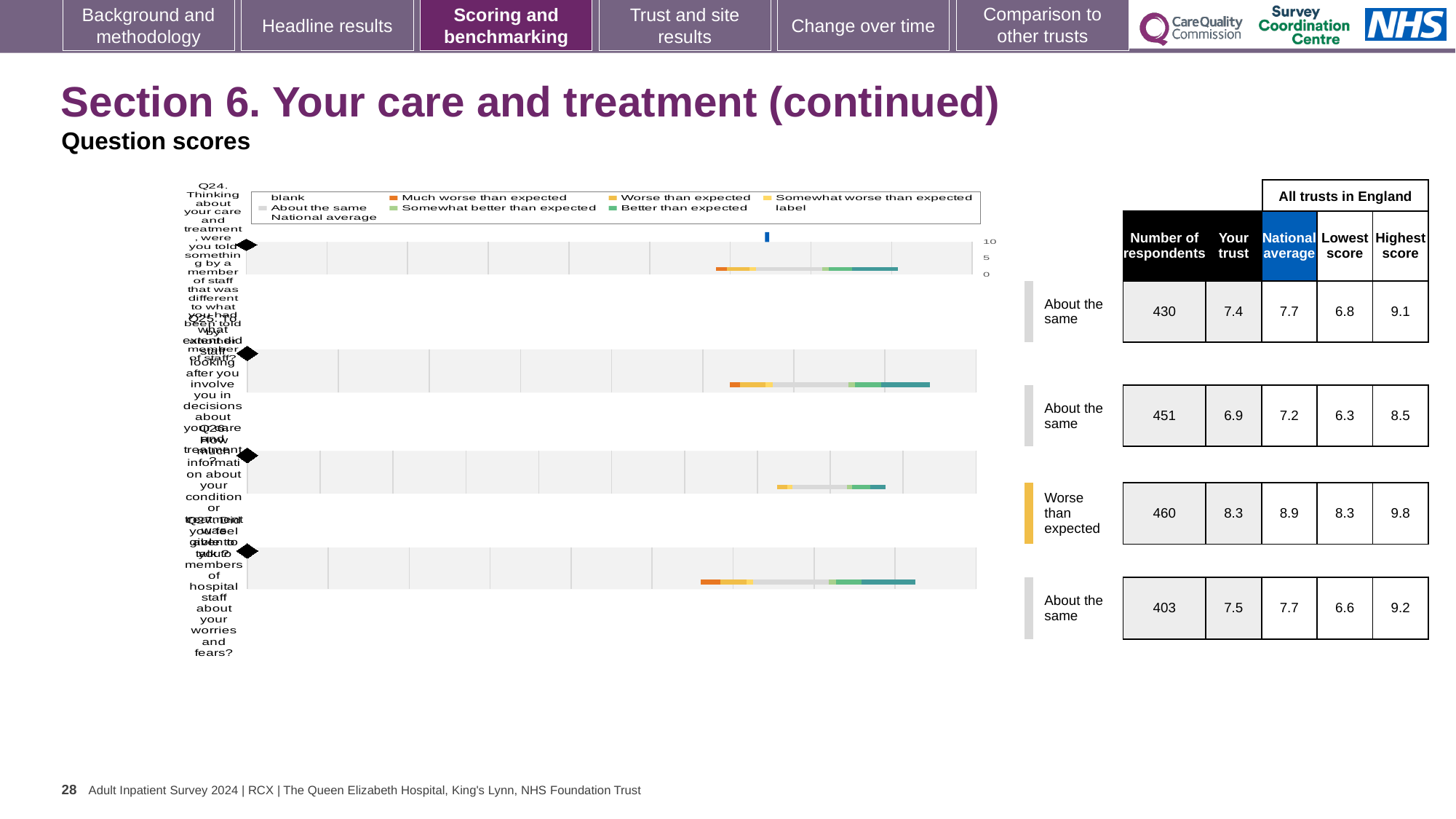
What is the 'Your trust' score for Q24? 7.4 For Q25, which is larger: the 'Your trust' score or the national average? National average What is the highest score among all trusts in England for Q26? 9.8 How many respondents answered Q27? 403 Which benchmark category is Q26 placed in? Worse than expected How many question charts are shown on the slide? 4 Which question has the lowest number of respondents? Q27 For Q24, what is the difference between the national average and the 'Your trust' score? 0.3 Which question has the highest 'Your trust' score? Q26 For Q26, what is the difference between the national average and the 'Your trust' score? 0.6 What is the national average score for Q25? 7.2 What kind of chart is used for each question's benchmarking? Bar chart